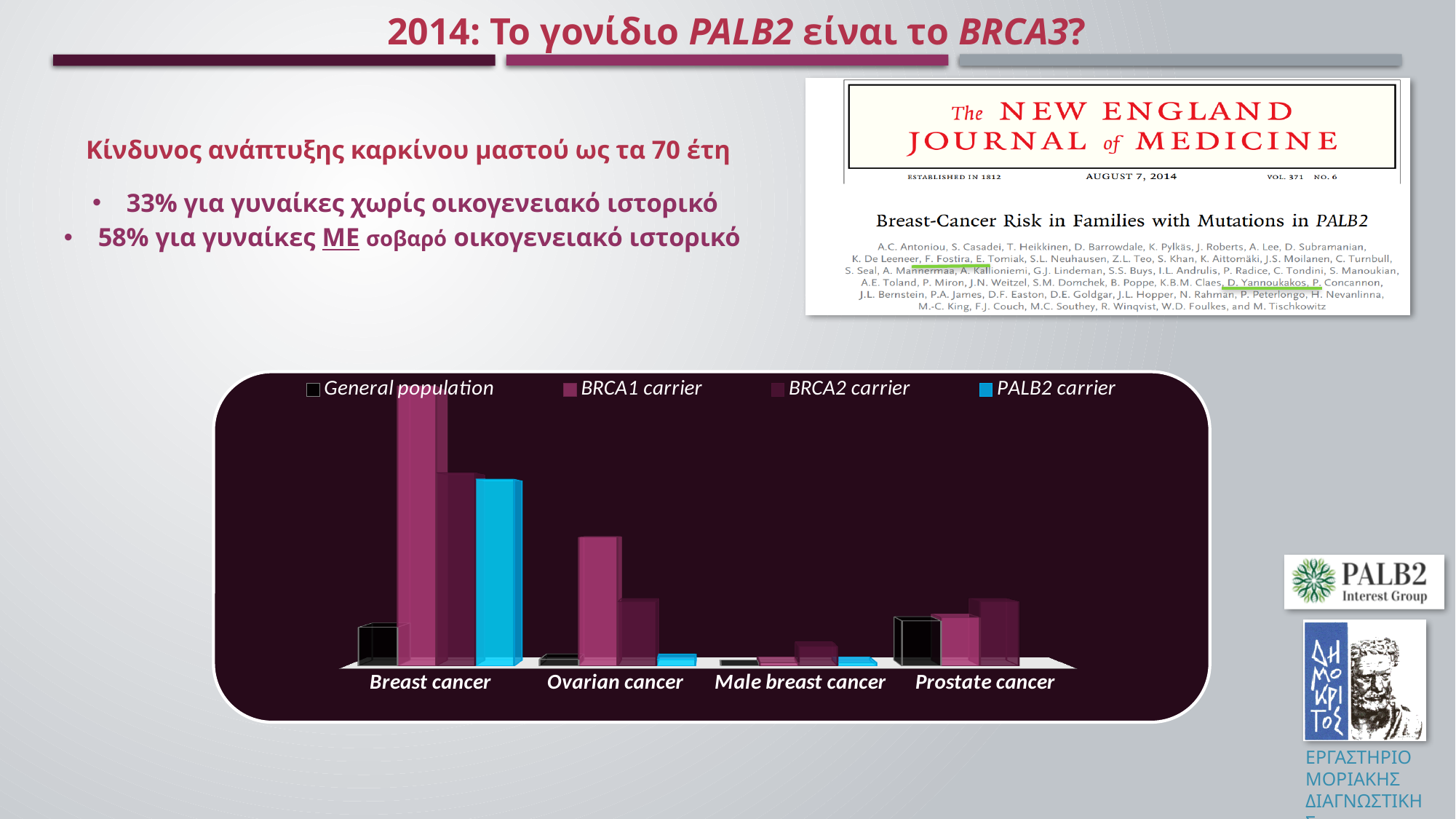
Which cancer category has the lowest bars overall in the chart? Male breast cancer What colour is used for the PALB2 carrier series in the chart? blue How many series does the chart legend list? 4 Which series has the tallest bar in the Prostate cancer category? BRCA2 carrier How many cancer categories are shown on the x axis of the chart? 4 For the PALB2 carrier series, which is larger: the Breast cancer bar or the Ovarian cancer bar? Breast cancer Which series has the shortest bar in the Breast cancer category? General population Which series has the tallest bar in the Breast cancer category? BRCA1 carrier Which cancer category contains the tallest bar in the whole chart? Breast cancer What kind of chart is shown on the slide? bar chart In the Ovarian cancer category, which is larger: the BRCA1 carrier bar or the BRCA2 carrier bar? BRCA1 carrier